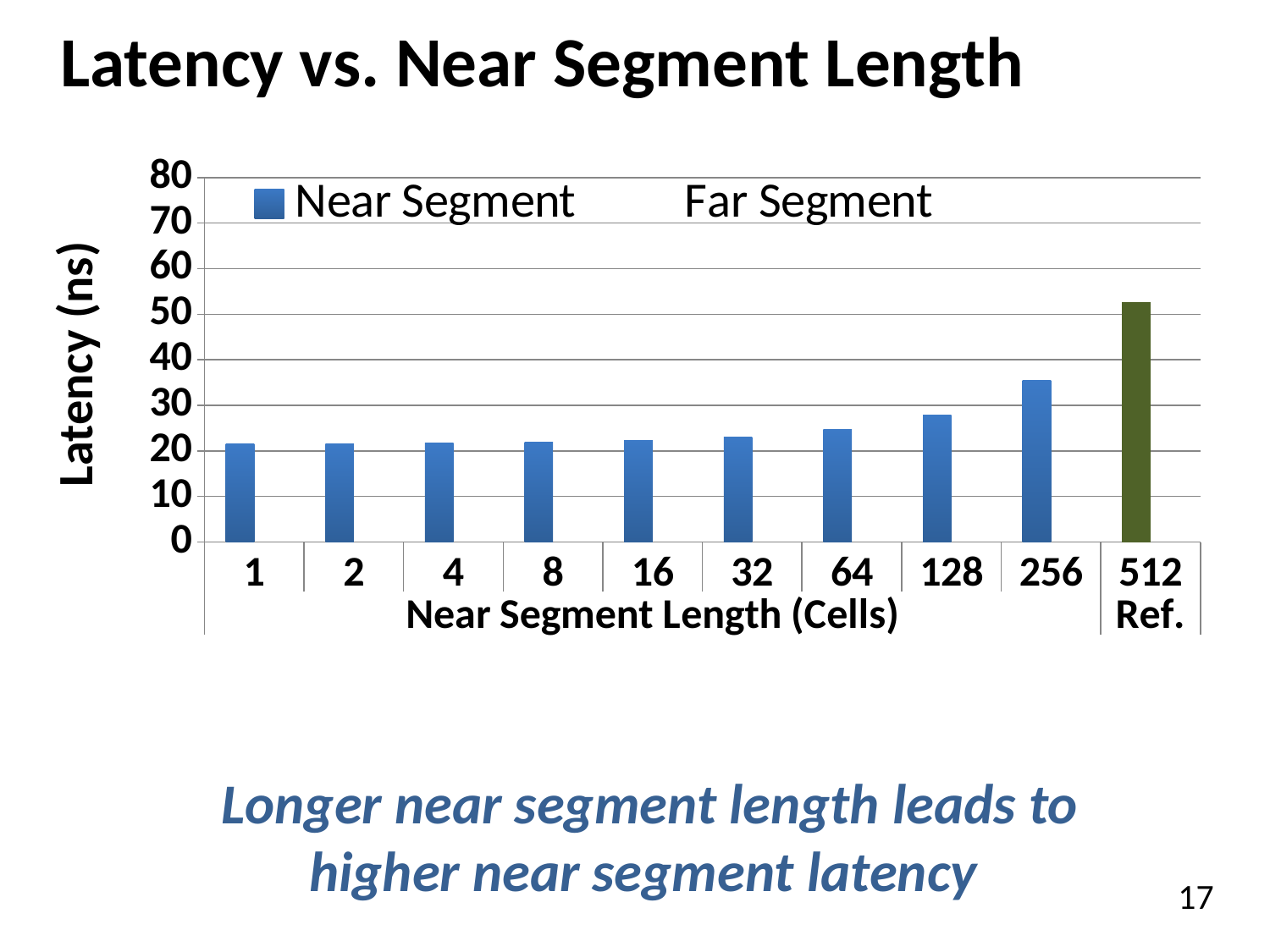
How many series does the legend list? 2 How many bars (categories) are plotted along the x axis? 10 Is the latency for 256 greater or less than 40? less Which category has the highest latency? 512 Ref. What kind of chart is shown on the slide? bar chart Is the latency for 256 greater or less than 30? greater Do the near segment latency values rise or fall as near segment length increases along the x axis? rise What is the label of the y axis? Latency (ns) Which has the higher latency, near segment length 128 or 256? 256 Is the latency for near segment length 1 greater or less than 20? greater